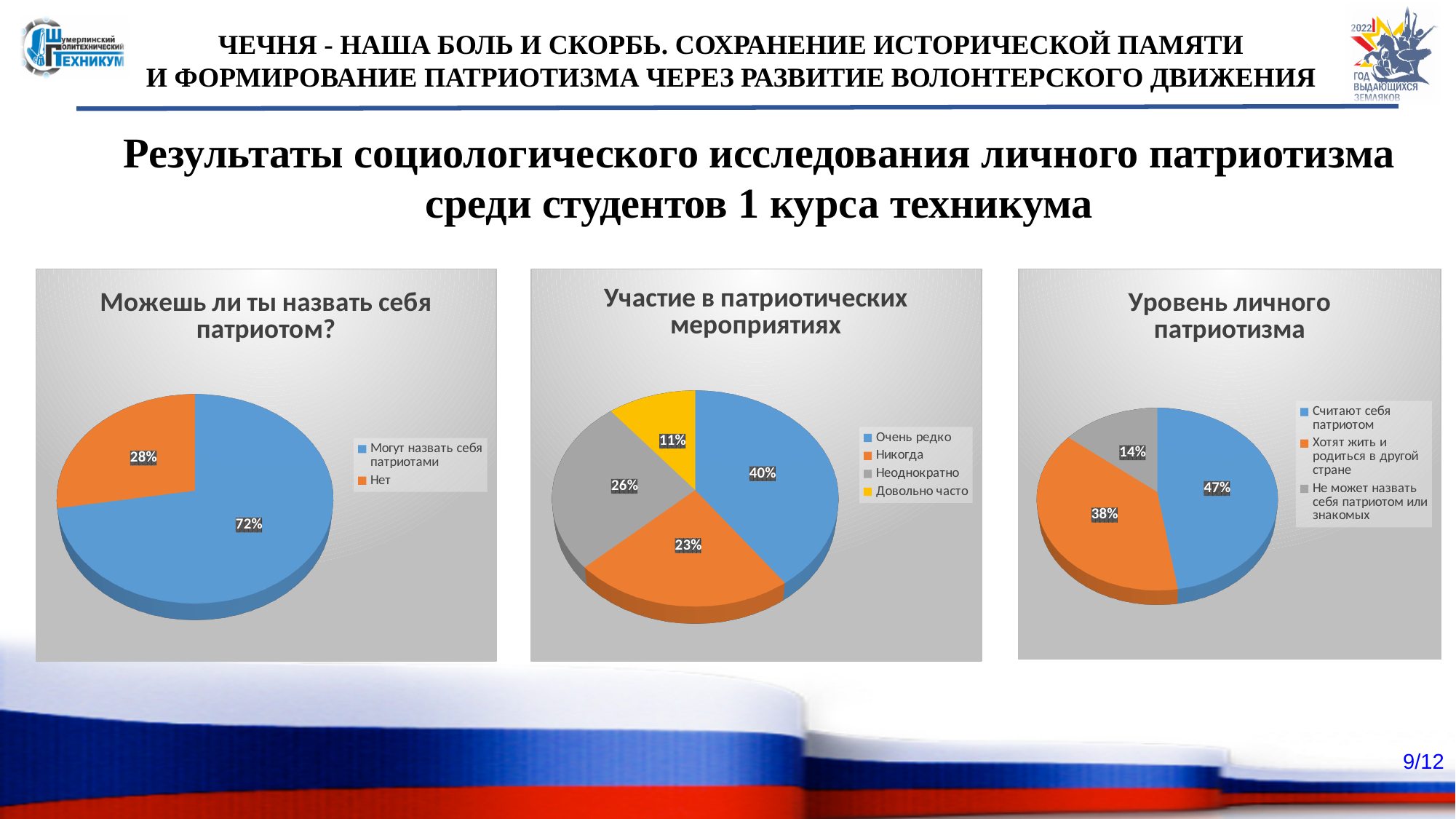
In the chart 'Можешь ли ты назвать себя патриотом?', what share of respondents answered 'Нет'? 28% In the chart 'Участие в патриотических мероприятиях', what is the difference between 'Очень редко' and 'Неоднократно'? 14% In the chart 'Уровень личного патриотизма', what is the difference between 'Считают себя патриотом' and 'Хотят жить и родиться в другой стране'? 9% In the chart 'Участие в патриотических мероприятиях', which category has the largest slice? Очень редко What type of chart is used for 'Уровень личного патриотизма'? Pie chart In the chart 'Уровень личного патриотизма', what is the value for 'Хотят жить и родиться в другой стране'? 38% How many charts are shown on the slide? 3 In the chart 'Можешь ли ты назвать себя патриотом?', what share of respondents can call themselves patriots ('Могут назвать себя патриотами')? 72% In the chart 'Уровень личного патриотизма', which is larger: 'Считают себя патриотом' or 'Не может назвать себя патриотом или знакомых'? Считают себя патриотом In the chart 'Участие в патриотических мероприятиях', what is the value for 'Никогда'? 23% In the chart 'Участие в патриотических мероприятиях', how many categories does the legend list? 4 In the chart 'Участие в патриотических мероприятиях', which category has the smallest slice? Довольно часто